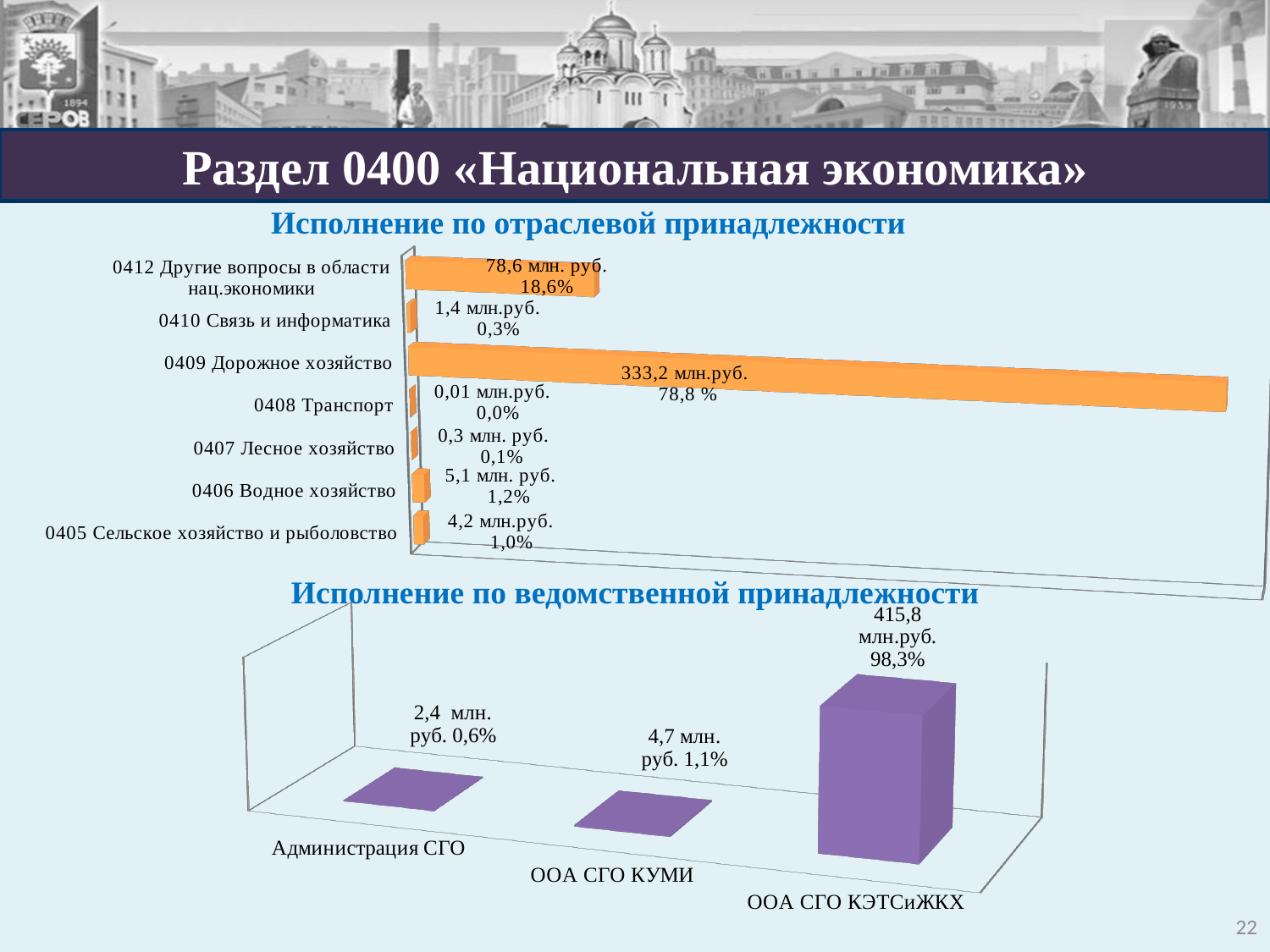
In the chart 'Исполнение по отраслевой принадлежности', which is larger: 0406 Водное хозяйство or 0405 Сельское хозяйство и рыболовство? 0406 Водное хозяйство In the chart 'Исполнение по отраслевой принадлежности', what percentage is shown for 0412 Другие вопросы в области нац.экономики? 18,6% In the chart 'Исполнение по отраслевой принадлежности', what is the value for 0409 Дорожное хозяйство? 333,2 млн.руб. What type of chart is 'Исполнение по отраслевой принадлежности'? Bar chart How many categories are shown in the chart 'Исполнение по ведомственной принадлежности'? 3 In the chart 'Исполнение по ведомственной принадлежности', what percentage is shown for Администрация СГО? 0,6% In the chart 'Исполнение по ведомственной принадлежности', what is the value for ООА СГО КЭТСиЖКХ? 415,8 млн.руб. In the chart 'Исполнение по отраслевой принадлежности', what is the difference in млн. руб. between 0409 Дорожное хозяйство and 0412 Другие вопросы в области нац.экономики? 254,6 млн. руб. How many categories are shown in the chart 'Исполнение по отраслевой принадлежности'? 7 In the chart 'Исполнение по отраслевой принадлежности', which category has the highest value? 0409 Дорожное хозяйство In the chart 'Исполнение по ведомственной принадлежности', what is the difference in млн. руб. between ООА СГО КЭТСиЖКХ and ООА СГО КУМИ? 411,1 млн. руб. In the chart 'Исполнение по отраслевой принадлежности', which category has the lowest value? 0408 Транспорт